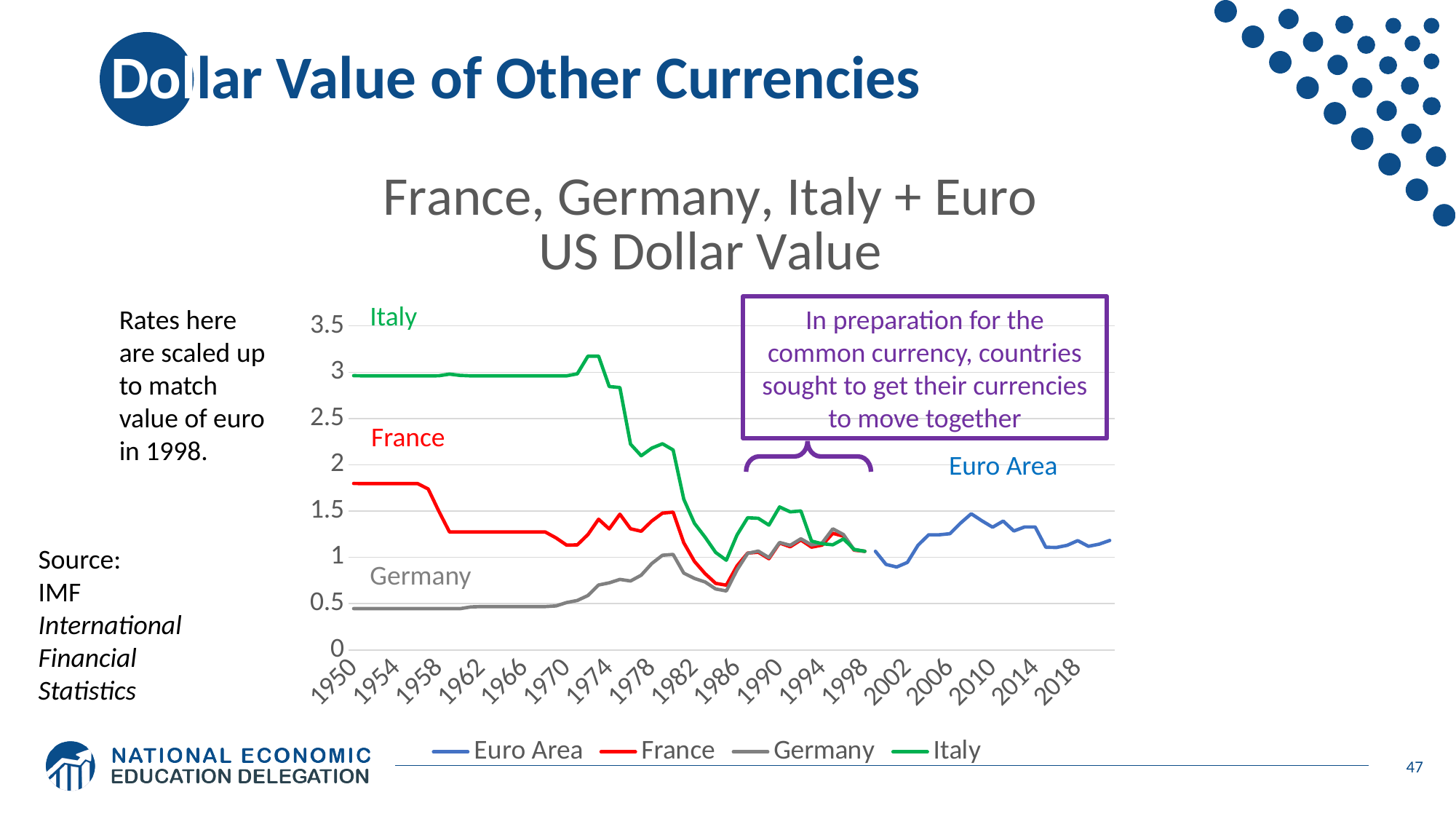
Which series has the highest value in 1950? Italy Does the Germany line rise or fall overall from 1950 to 1998? rise Which series has the lowest value in 1950? Germany What kind of chart is shown on the slide? line chart Is the value for France in 1950 greater or less than 1.5? greater Is the value for Germany in 1950 greater or less than 1? less How many series does the chart legend list? 4 In 1970, which is larger: the value for France or the value for Germany? France Is the value for Italy in 1950 greater or less than 2.5? greater What are the series listed in the chart legend? Euro Area, France, Germany, Italy Does the Italy line rise or fall overall from 1950 to 1998? fall What is the title of the chart? France, Germany, Italy + Euro US Dollar Value